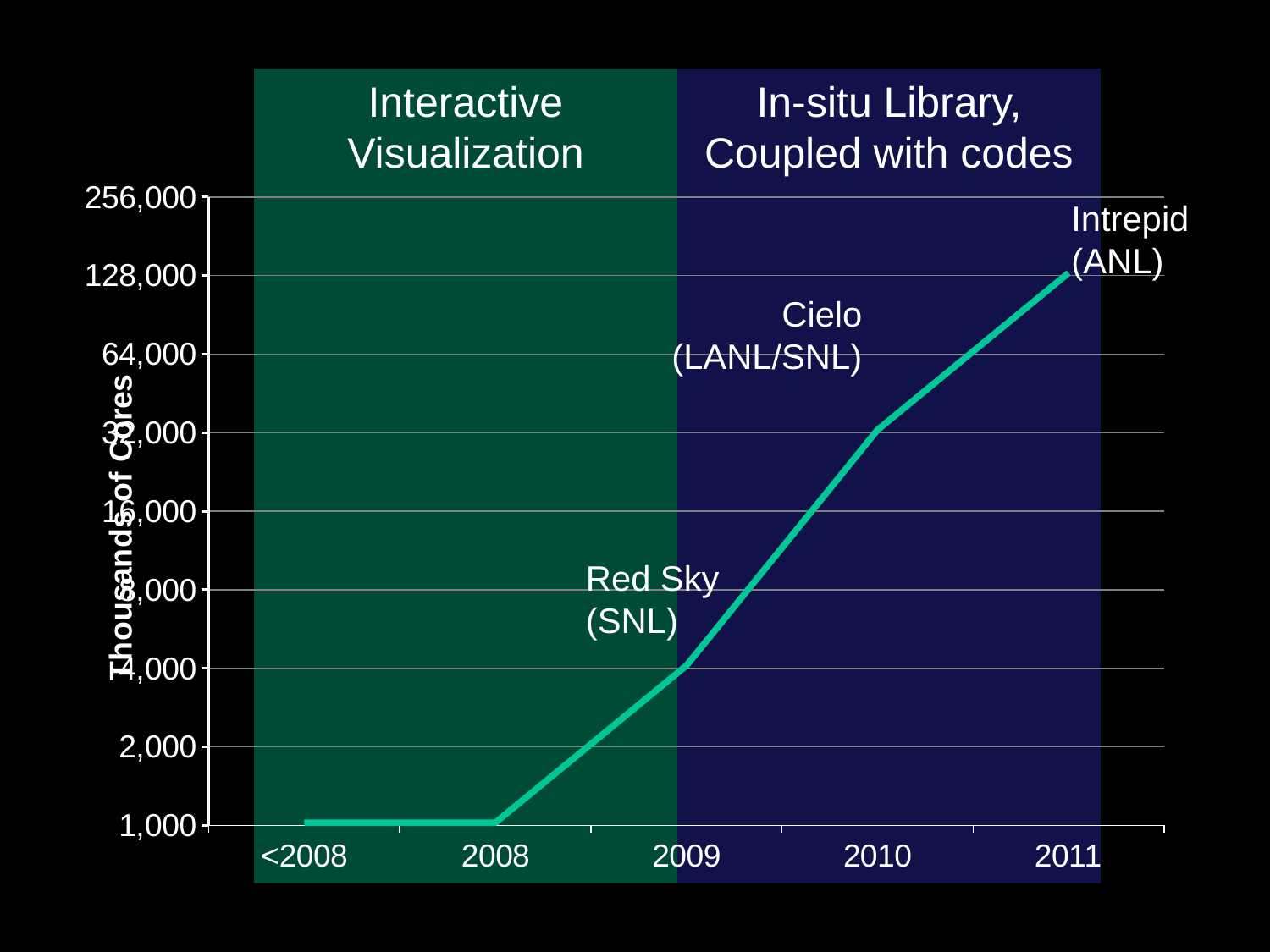
What kind of chart is shown on the slide? line chart What is the value for 2011? 128,000 How many points are plotted along the x axis? 5 Do the values rise or fall from 2008 to 2011? rise What is the value for 2010? 32,000 Which year has the highest value? 2011 What is the value for 2009? 4,000 What is the value for 2008? 1,000 What is the difference between the values for 2011 and 2010? 96,000 Which system is labelled at the 2011 point? Intrepid (ANL) What is the label of the y axis? Thousands of Cores Which is larger, the value for 2010 or the value for 2009? 2010